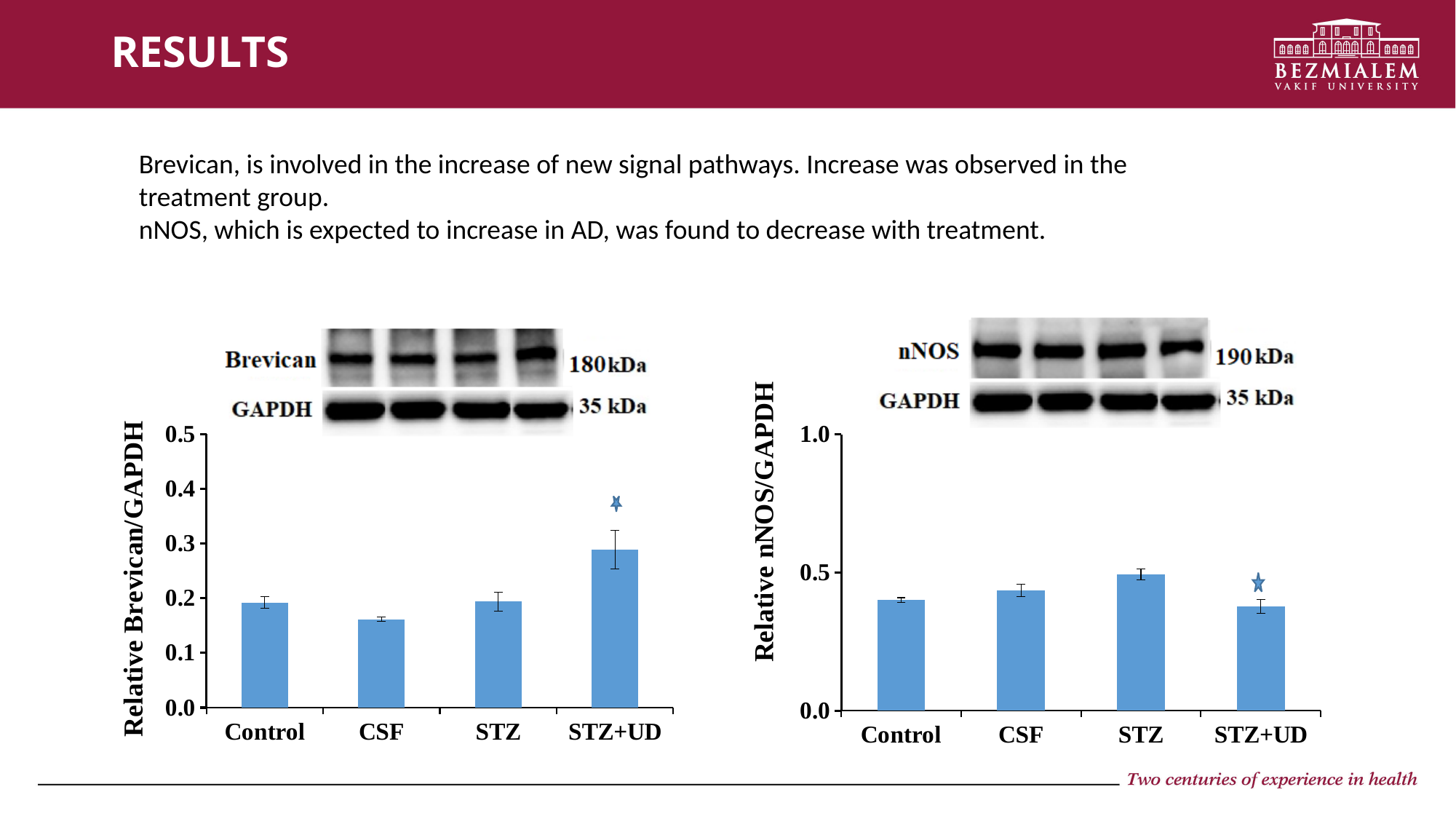
In the left chart (Relative Brevican/GAPDH), is the value for STZ+UD greater or less than 0.2? greater In the left chart (Relative Brevican/GAPDH), which is larger, the value for STZ+UD or the value for Control? STZ+UD In the left chart (Relative Brevican/GAPDH), is the value for CSF greater or less than 0.2? less What kind of chart is the left chart (Relative Brevican/GAPDH)? bar chart In the left chart (Relative Brevican/GAPDH), which category has the lowest bar? CSF In the right chart (Relative nNOS/GAPDH), which category has the highest bar? STZ What is the highest tick value shown on the y axis of the left chart (Relative Brevican/GAPDH)? 0.5 In the left chart (Relative Brevican/GAPDH), which category has the highest bar? STZ+UD How many categories are shown on the x axis of the right chart (Relative nNOS/GAPDH)? 4 In the right chart (Relative nNOS/GAPDH), is the value for Control greater or less than 0.5? less In the right chart (Relative nNOS/GAPDH), which is larger, the value for STZ or the value for Control? STZ What is the y-axis label of the right chart? Relative nNOS/GAPDH